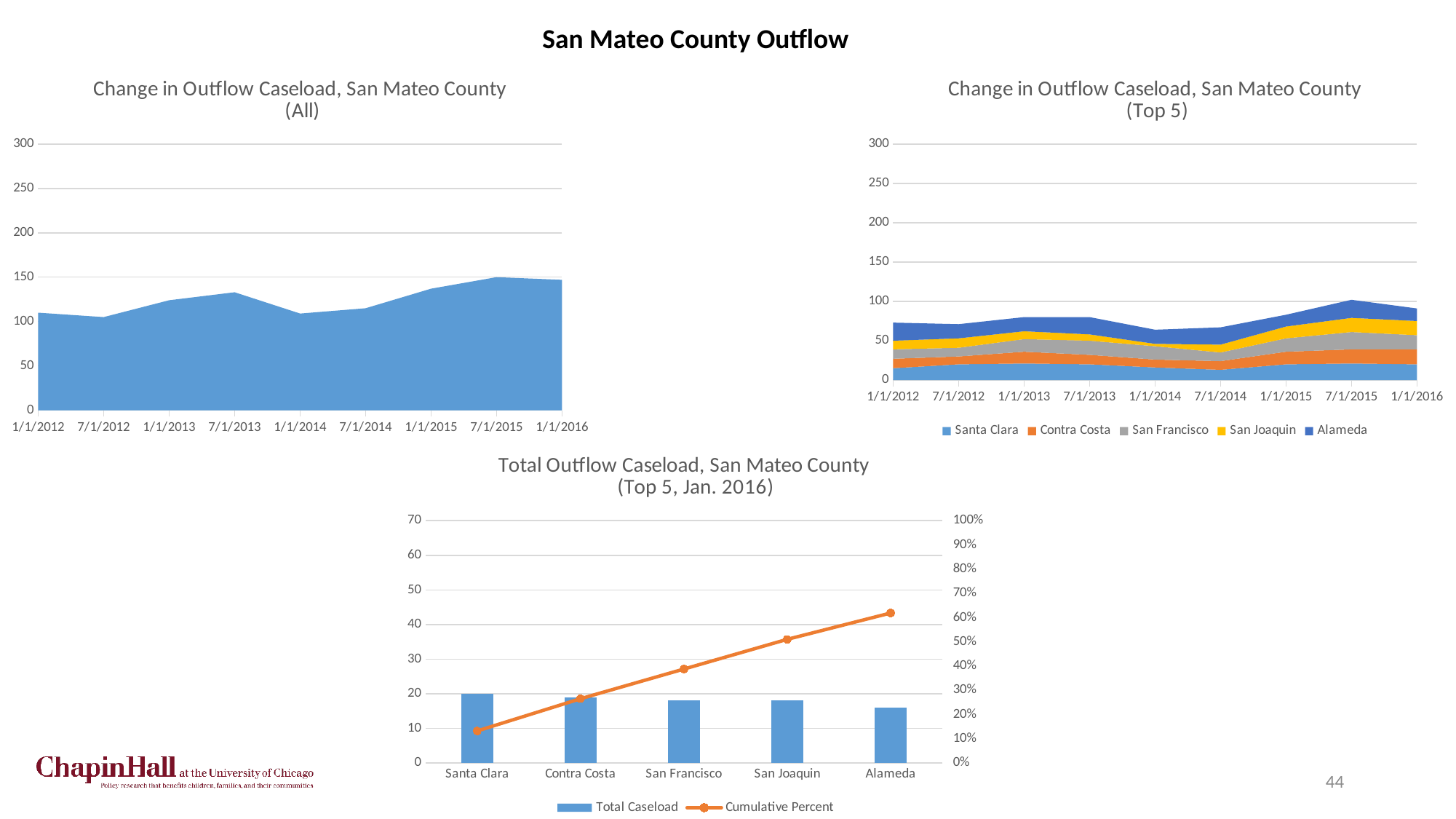
In the 'Total Outflow Caseload, San Mateo County (Top 5, Jan. 2016)' chart, how many series does the legend list? 2 In the 'Change in Outflow Caseload, San Mateo County (Top 5)' chart, which county is listed first in the legend? Santa Clara In the 'Total Outflow Caseload, San Mateo County (Top 5, Jan. 2016)' chart, how many counties are shown on the x axis? 5 In the 'Total Outflow Caseload, San Mateo County (Top 5, Jan. 2016)' chart, which county has the highest Total Caseload? Santa Clara In the 'Change in Outflow Caseload, San Mateo County (All)' chart, is the value at 7/1/2015 greater or less than 100? greater In the 'Change in Outflow Caseload, San Mateo County (Top 5)' chart, is the stacked total at 1/1/2014 greater or less than 100? less In the 'Total Outflow Caseload, San Mateo County (Top 5, Jan. 2016)' chart, which has the larger Total Caseload, Santa Clara or Alameda? Santa Clara In the 'Change in Outflow Caseload, San Mateo County (All)' chart, does the caseload rise or fall between 1/1/2014 and 7/1/2015? rise In the 'Change in Outflow Caseload, San Mateo County (Top 5)' chart, how many series does the legend list? 5 In the 'Total Outflow Caseload, San Mateo County (Top 5, Jan. 2016)' chart, what kind of chart is used for the Total Caseload series? Bar chart In the 'Total Outflow Caseload, San Mateo County (Top 5, Jan. 2016)' chart, which county has the lowest Total Caseload? Alameda In the 'Total Outflow Caseload, San Mateo County (Top 5, Jan. 2016)' chart, is the Cumulative Percent at Alameda greater or less than 50%? greater